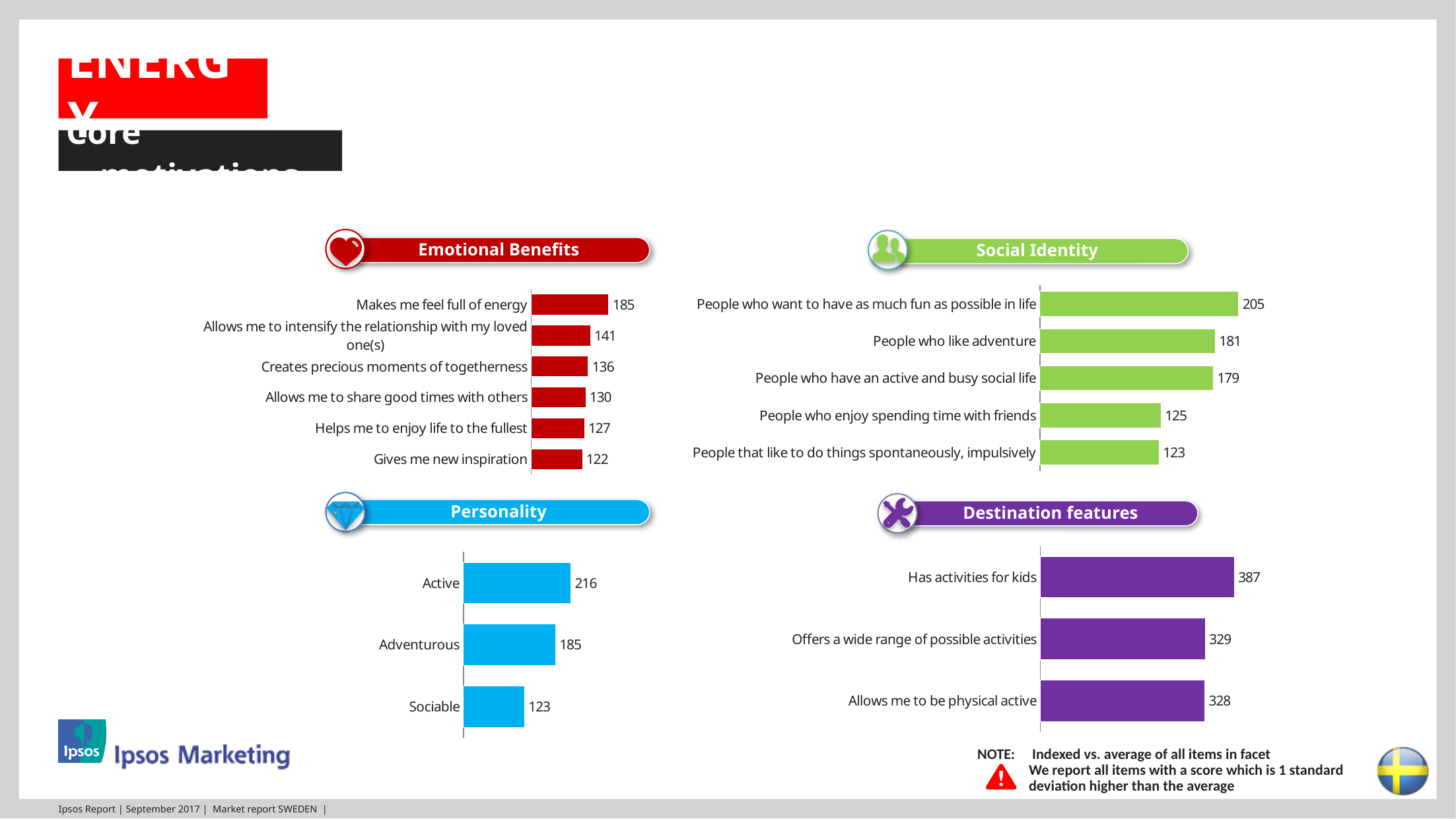
In the Personality chart, what is the value for Adventurous? 185 What type of chart is the Personality chart? Bar chart In the Personality chart, how many categories are shown? 3 In the Emotional Benefits chart, which category has the lowest value? Gives me new inspiration In the Social Identity chart, what is the difference between "People who want to have as much fun as possible in life" and "People that like to do things spontaneously, impulsively"? 82 In the Social Identity chart, what is the value for "People who like adventure"? 181 In the Emotional Benefits chart, what is the value for "Makes me feel full of energy"? 185 In the Emotional Benefits chart, how many categories are shown? 6 In the Destination features chart, what is the difference between "Has activities for kids" and "Offers a wide range of possible activities"? 58 In the Destination features chart, what is the value for "Has activities for kids"? 387 In the Destination features chart, which is larger: "Offers a wide range of possible activities" or "Allows me to be physical active"? Offers a wide range of possible activities In the Social Identity chart, which category has the highest value? People who want to have as much fun as possible in life